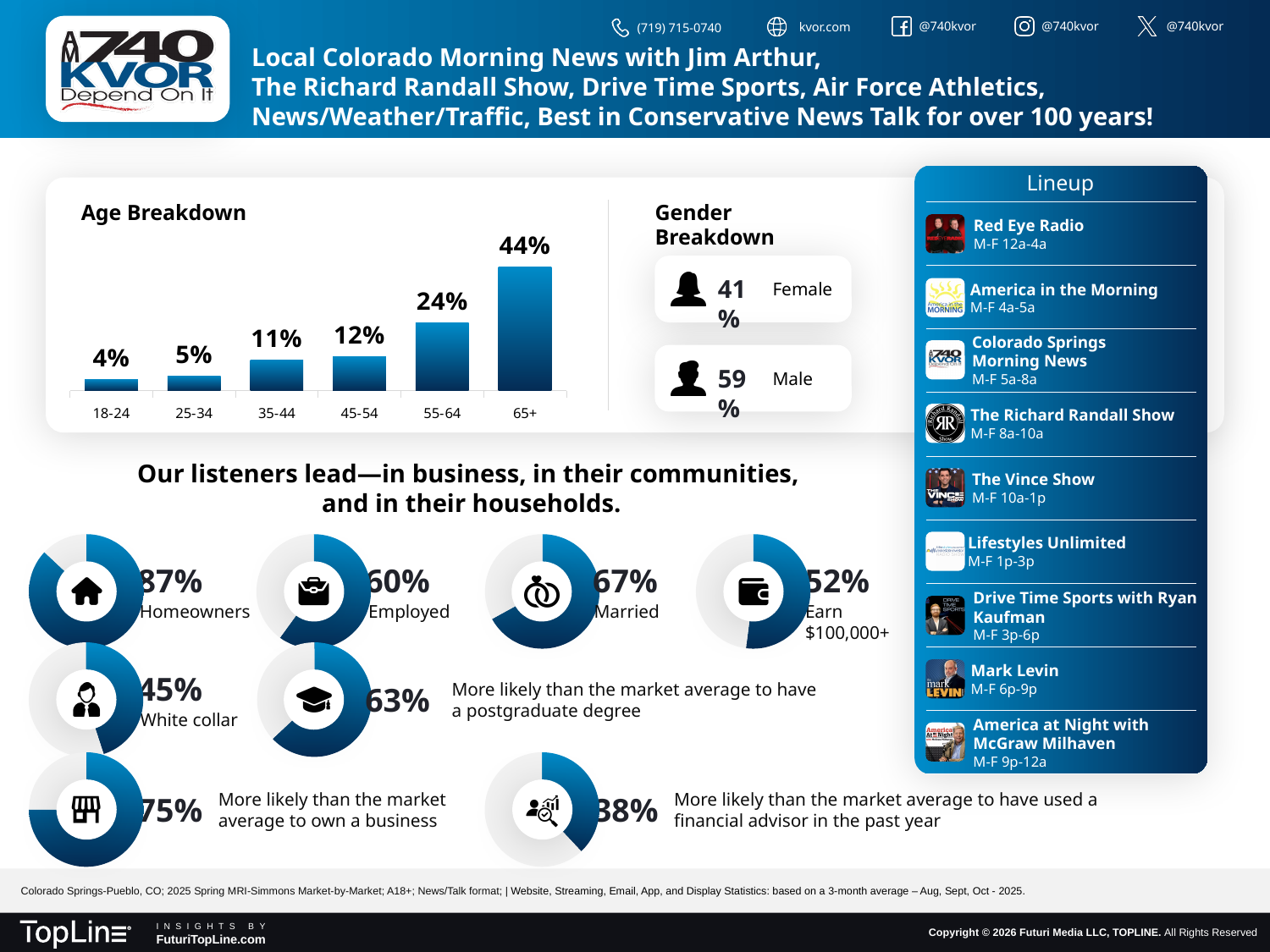
In the Age Breakdown chart, do the values rise or fall from 18-24 to 65+? rise In the Age Breakdown chart, which is larger, the value for 45-54 or the value for 25-34? 45-54 What kind of chart is the Age Breakdown chart? bar chart In the Age Breakdown chart, what is the value for the 65+ age group? 44% In the Gender Breakdown, what is the difference between the Male and Female percentages? 18% In the Age Breakdown chart, which age group has the highest value? 65+ In the Age Breakdown chart, which age group has the lowest value? 18-24 In the donut charts at the bottom of the slide, what percentage of listeners are Homeowners? 87% In the Gender Breakdown, what percentage of listeners are Male? 59% In the Age Breakdown chart, what is the value for the 35-44 age group? 11% How many age groups are shown in the Age Breakdown chart? 6 In the Age Breakdown chart, what is the difference between the values for 65+ and 55-64? 20%